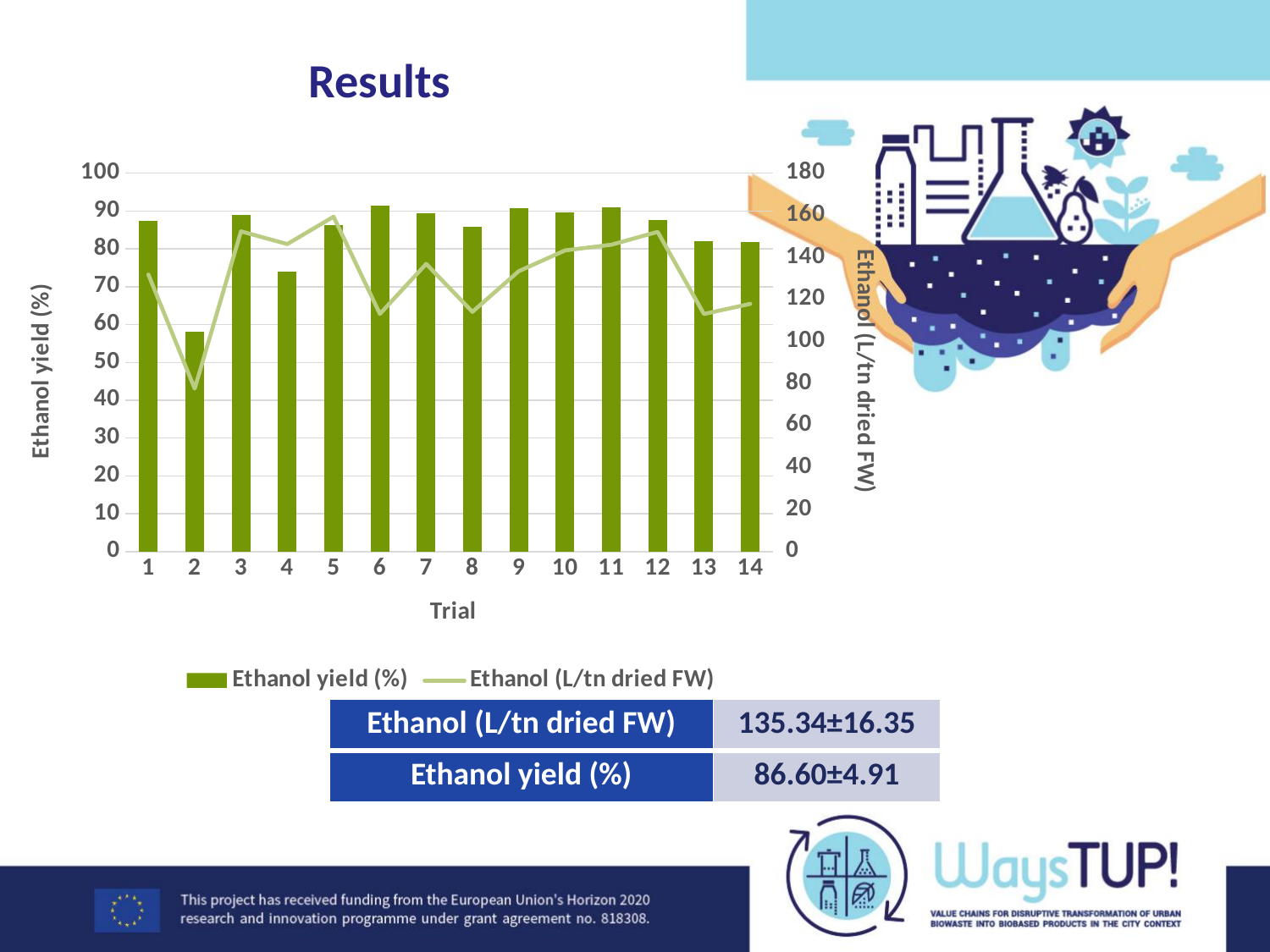
How many trials are shown on the x axis of the chart? 14 Which trial has the lowest value on the Ethanol (L/tn dried FW) line? 2 Is the Ethanol (L/tn dried FW) value for trial 5 greater or less than 140? greater Is the Ethanol yield (%) for trial 2 greater or less than 60? less Which trial has the lowest Ethanol yield (%) bar? 2 Is the Ethanol yield (%) for trial 4 greater or less than 70? greater What kind of chart is shown on the slide? Combination bar and line chart Which trial has a higher Ethanol yield (%), trial 2 or trial 3? 3 How many series does the chart legend list? 2 What is the title of the x axis of the chart? Trial Which trial has the highest value on the Ethanol (L/tn dried FW) line? 5 What is the title of the left y axis of the chart? Ethanol yield (%)